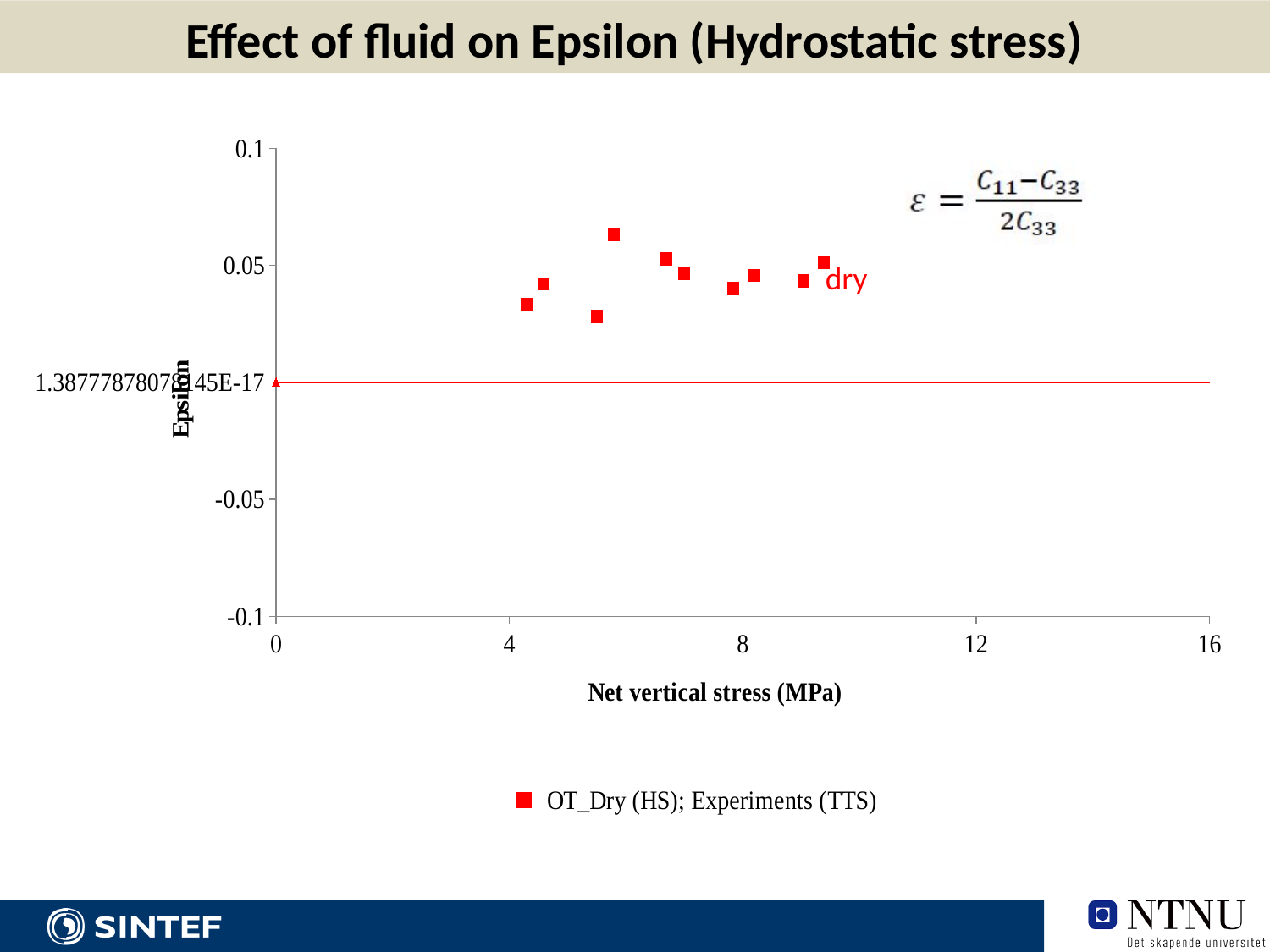
Is the lowest plotted Epsilon value greater or less than 0.05? less Are all the plotted Epsilon values greater or less than 0? greater Is the net vertical stress of the rightmost plotted point greater or less than 12 MPa? less What kind of chart is shown on the slide? scatter chart What is the title of the x axis? Net vertical stress (MPa) How many series does the legend list? 1 What is the legend entry for the plotted series? OT_Dry (HS); Experiments (TTS)